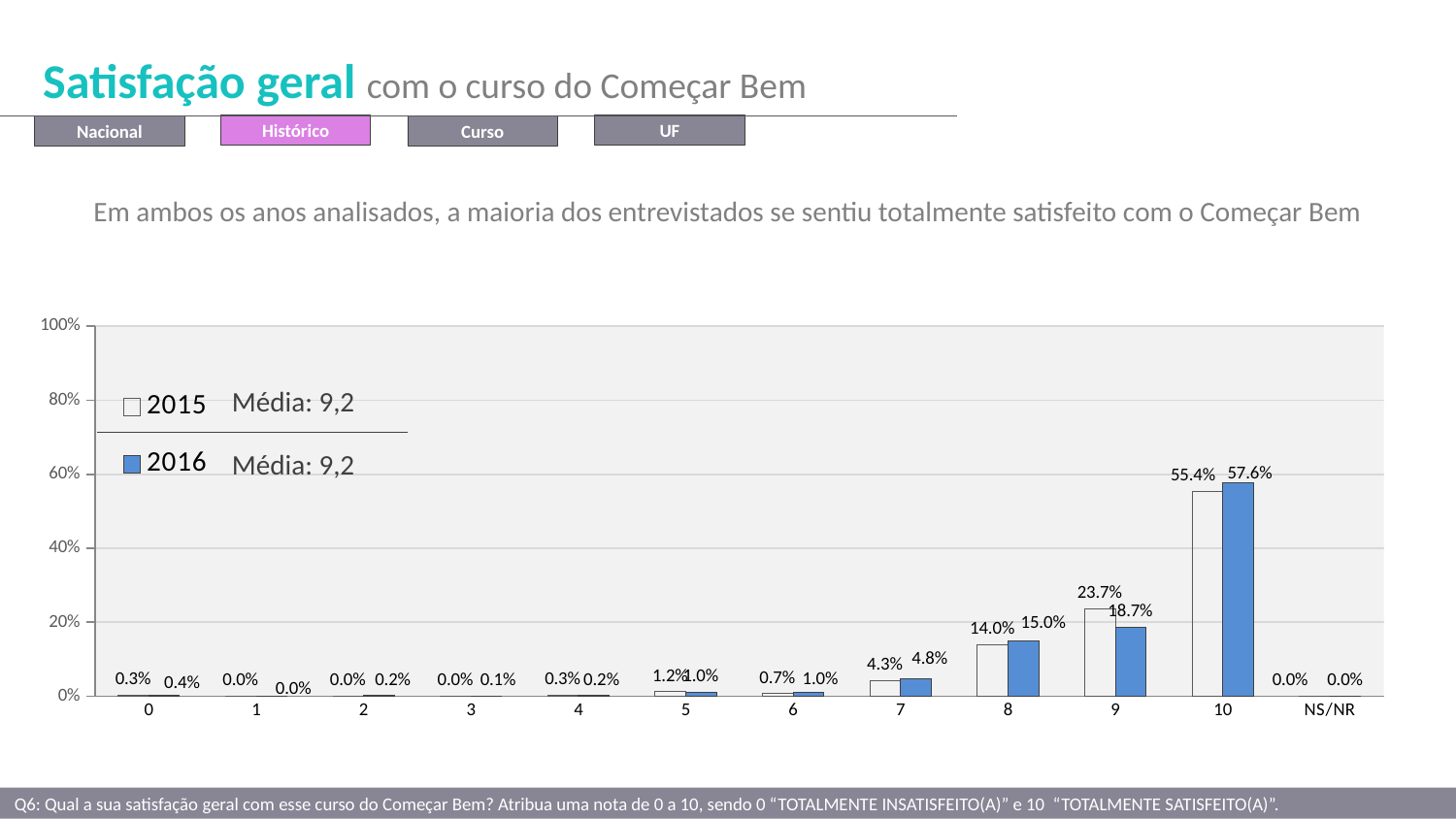
What average (Média) is shown in the legend for 2016? 9,2 What is the value for category 8 in the 2016 series? 15.0% What is the difference between the 2016 and 2015 values for category 10? 2.2% Which category has the highest value in the 2015 series? 10 How many categories are shown on the x axis? 12 Is the 2016 value for category 10 greater or less than 40%? greater What is the difference between the 2015 and 2016 values for category 9? 5.0% What is the value for category 10 in the 2016 series? 57.6% What is the value for category 9 in the 2015 series? 23.7% What kind of chart is shown on the slide? bar chart How many series does the legend list? 2 Which is larger for category 7: the 2015 value or the 2016 value? 2016